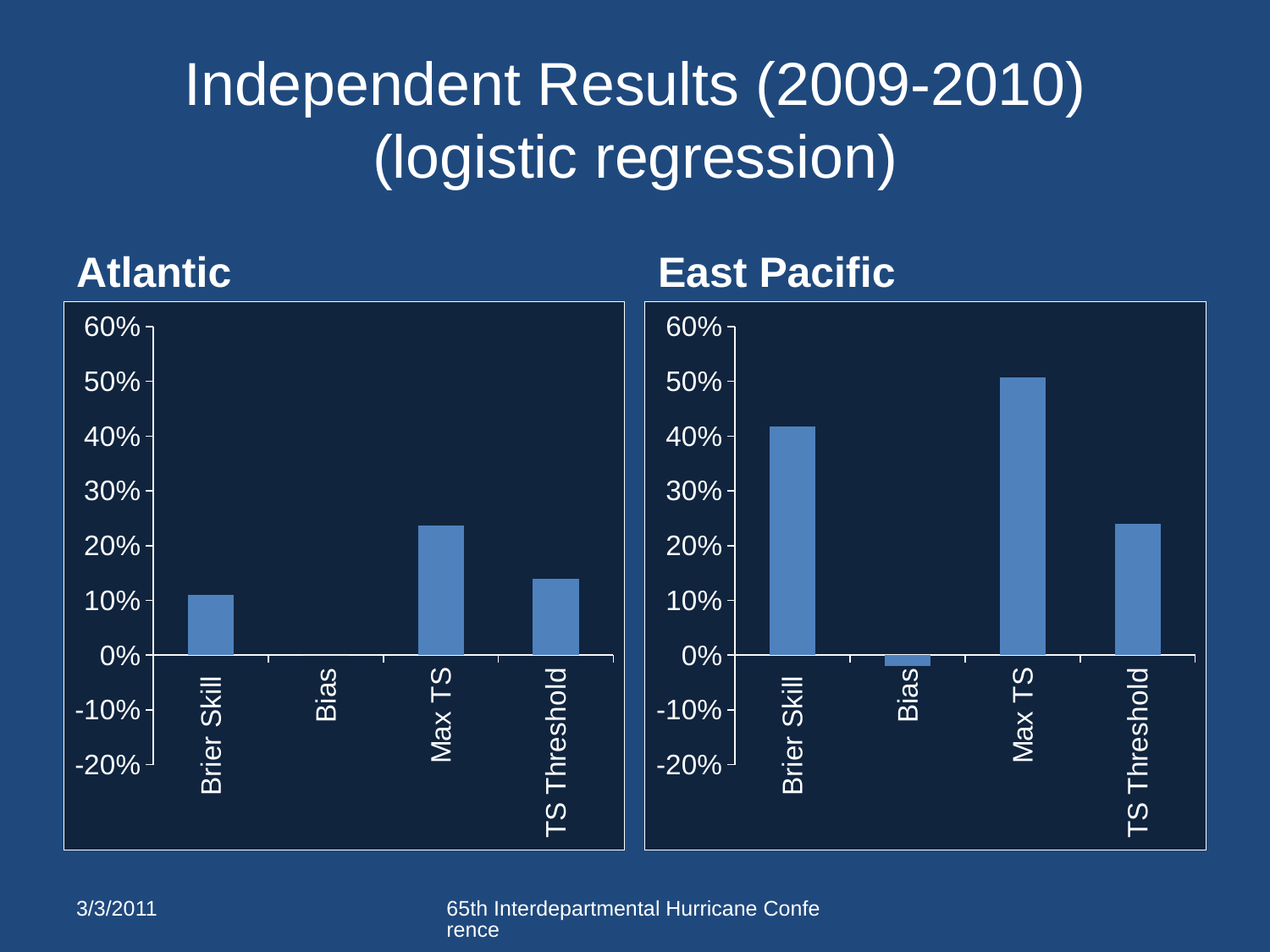
What type of chart is the Atlantic chart? bar chart What are the titles of the two charts on the slide? Atlantic and East Pacific In the Atlantic chart, which category has the highest value? Max TS In the Atlantic chart, is the value for Brier Skill greater or less than 20%? less In the East Pacific chart, which category has the lowest value? Bias In the East Pacific chart, which category has the highest value? Max TS In the Atlantic chart, which is larger, the value for TS Threshold or the value for Brier Skill? TS Threshold How many categories are shown on the x axis of the East Pacific chart? 4 In the East Pacific chart, is the value for Brier Skill greater or less than 40%? greater In the Atlantic chart, is the value for Max TS greater or less than 20%? greater In the East Pacific chart, which is larger, the value for Brier Skill or the value for TS Threshold? Brier Skill